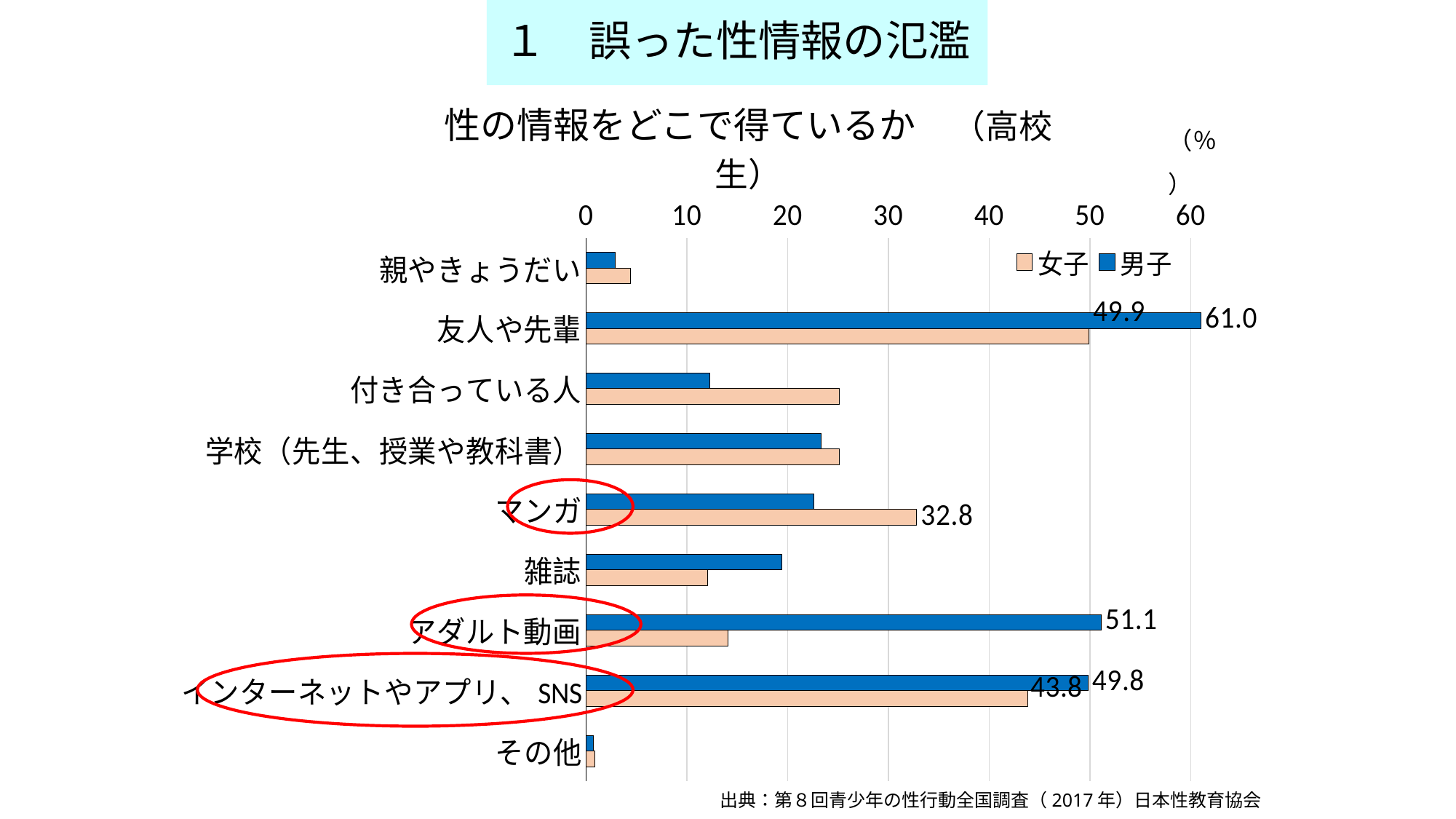
What is the 男子 value for 友人や先輩? 61.0 What is the 女子 value for インターネットやアプリ、SNS? 43.8 Is the 男子 value for 学校（先生、授業や教科書） greater or less than 20? greater What is the difference between the 男子 and 女子 values for 友人や先輩? 11.1 What is the difference between the 男子 and 女子 values for インターネットやアプリ、SNS? 6.0 What is the 男子 value for アダルト動画? 51.1 For 付き合っている人, which series has the larger value, 女子 or 男子? 女子 What is the 女子 value for マンガ? 32.8 What is the 女子 value for 友人や先輩? 49.9 Which category has the lowest 男子 value? その他 How many categories are shown on the chart? 9 Which category has the highest 男子 value? 友人や先輩